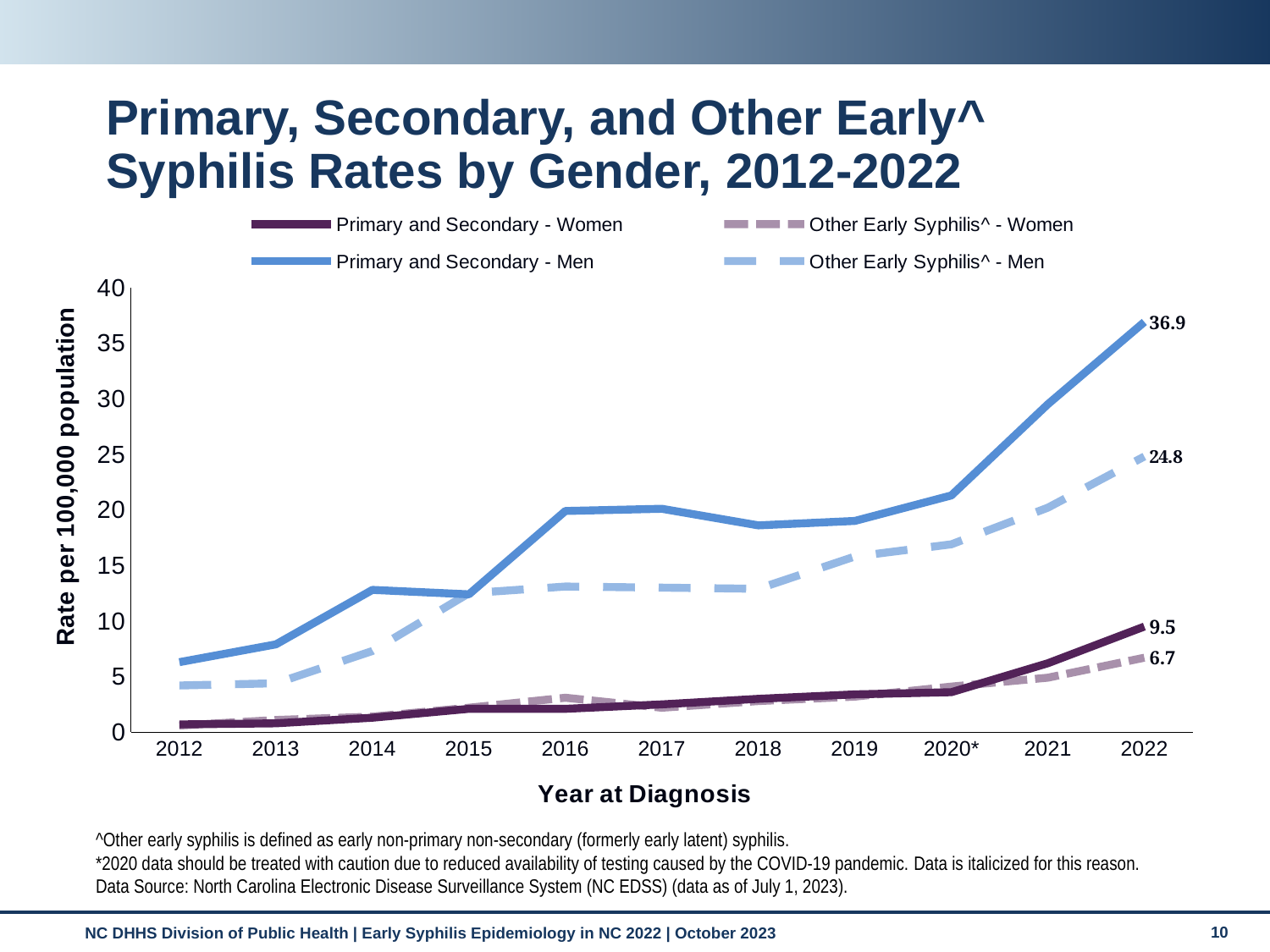
What is the Primary and Secondary - Men rate in 2022? 36.9 What is the Other Early Syphilis^ - Men rate in 2022? 24.8 Is the Primary and Secondary - Men rate in 2014 greater or less than 10? greater What is the difference between the Primary and Secondary - Men rate and the Other Early Syphilis^ - Men rate in 2022? 12.1 How many series does the legend list? 4 What is the Other Early Syphilis^ - Women rate in 2022? 6.7 In 2022, which is larger: the Primary and Secondary - Women rate or the Other Early Syphilis^ - Women rate? Primary and Secondary - Women What is the difference between the Primary and Secondary - Women rate and the Other Early Syphilis^ - Women rate in 2022? 2.8 What is the Primary and Secondary - Women rate in 2022? 9.5 What kind of chart is shown on the slide? line chart Which series has the highest rate in 2022? Primary and Secondary - Men Is the Other Early Syphilis^ - Men rate in 2012 greater or less than 5? less